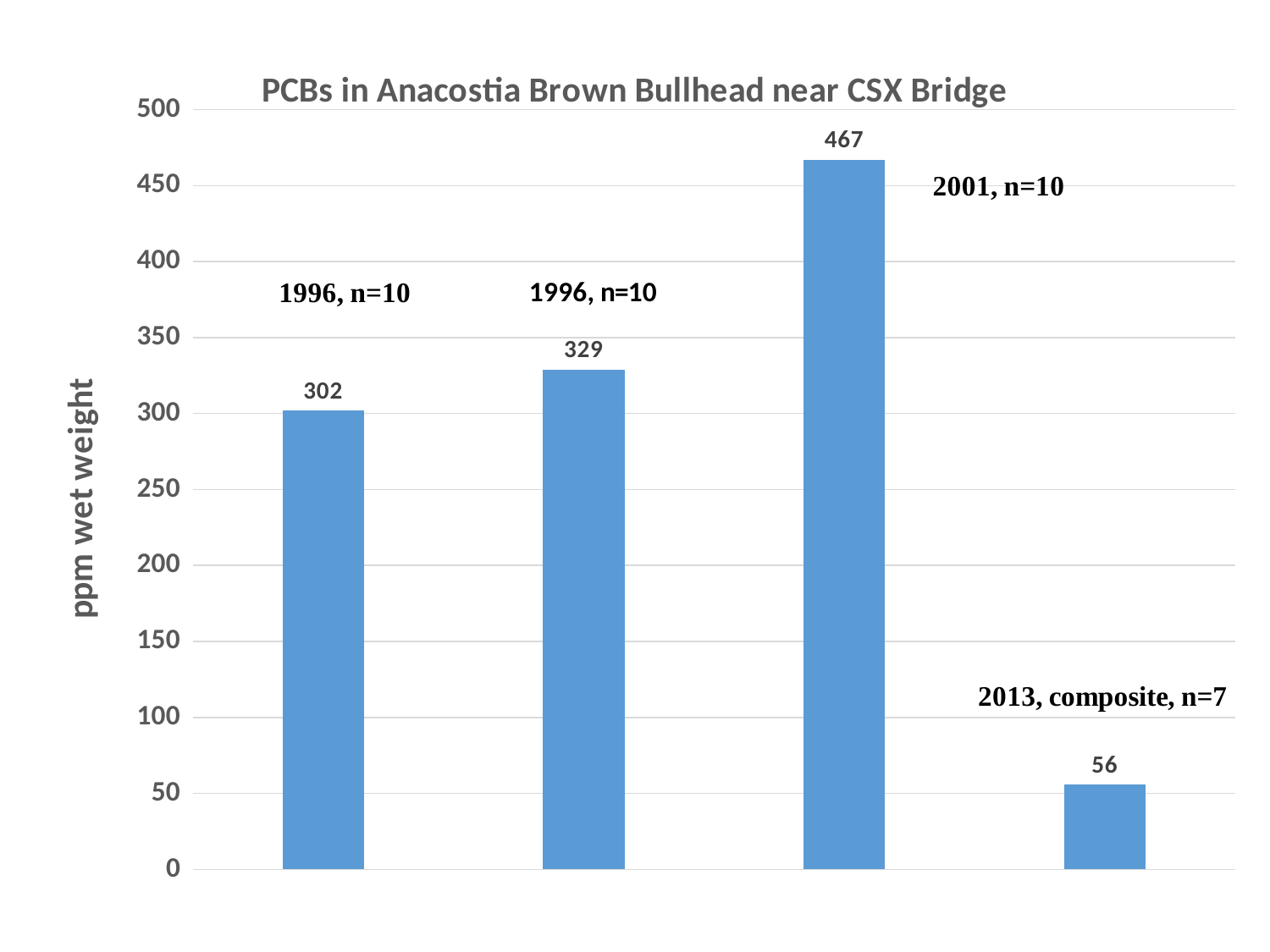
Which bar has the lowest value? 2013, composite, n=7 How many bars are plotted in the chart? 4 Which is larger: the 2001, n=10 bar or the second 1996, n=10 bar? 2001, n=10 What is the title of the chart? PCBs in Anacostia Brown Bullhead near CSX Bridge What is the difference between the 2001, n=10 bar and the 2013, composite, n=7 bar? 411 What is the value of the second bar from the left, labelled "1996, n=10"? 329 What is the label of the vertical axis? ppm wet weight What is the value of the bar labelled "2001, n=10"? 467 Which bar has the highest value? 2001, n=10 What type of chart is shown on the slide? bar chart What is the value of the bar labelled "2013, composite, n=7"? 56 What is the value of the first (leftmost) bar, labelled "1996, n=10"? 302